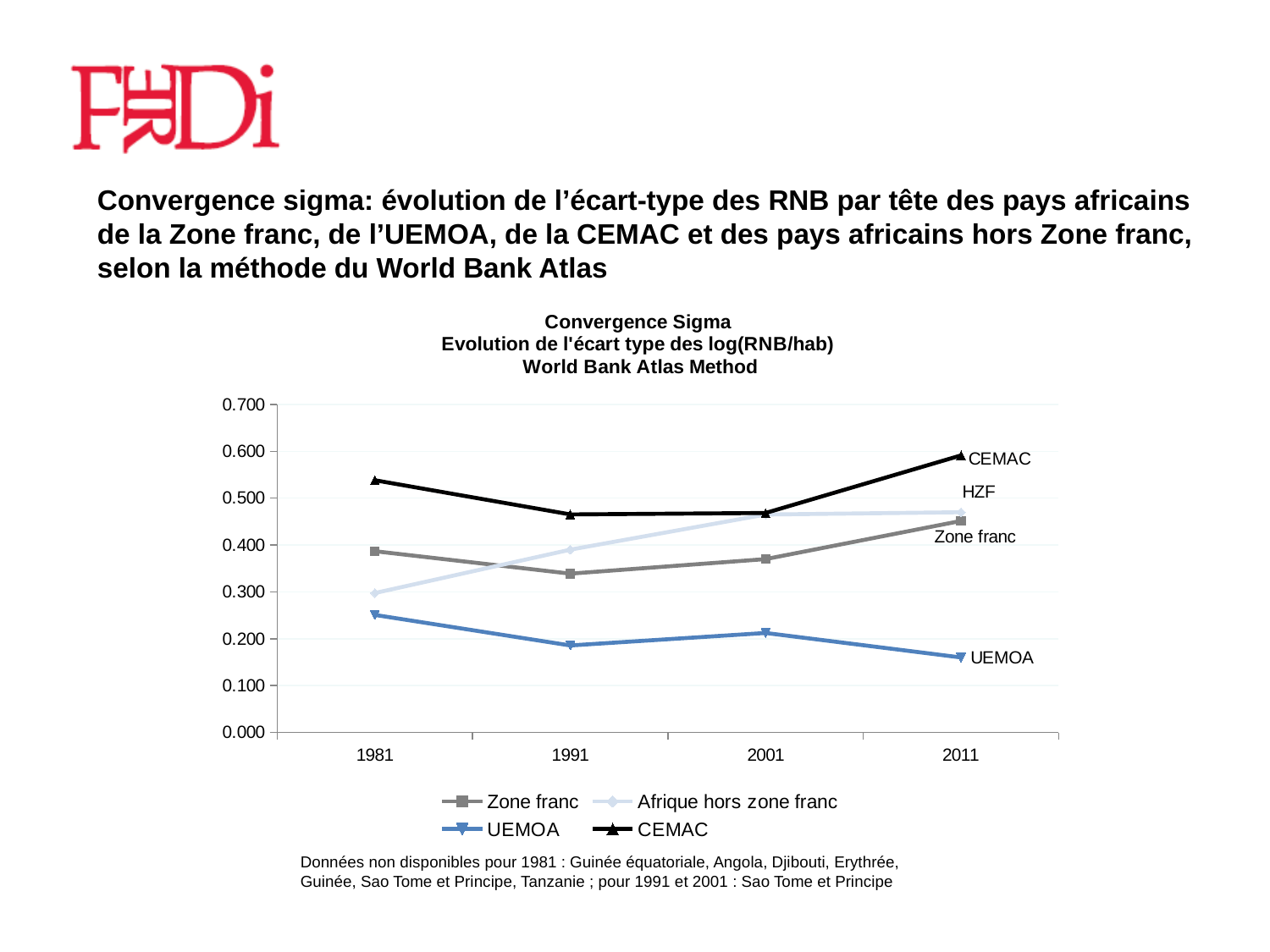
Is the value for Zone franc in 2011 greater or less than 0.400? greater How many series does the chart legend list? 4 What kind of chart is shown on the slide? line chart Does the Afrique hors zone franc series rise or fall from 1981 to 2011? rise Is the value for Afrique hors zone franc in 1981 greater or less than 0.400? less In 1981, which is larger: the value for Zone franc or the value for Afrique hors zone franc? Zone franc What is the first line of the chart's title? Convergence Sigma Which series has the highest value in 2011? CEMAC Is the value for UEMOA in 2011 greater or less than 0.200? less Which series has the lowest value in 1981? UEMOA How many years are shown on the x axis of the chart? 4